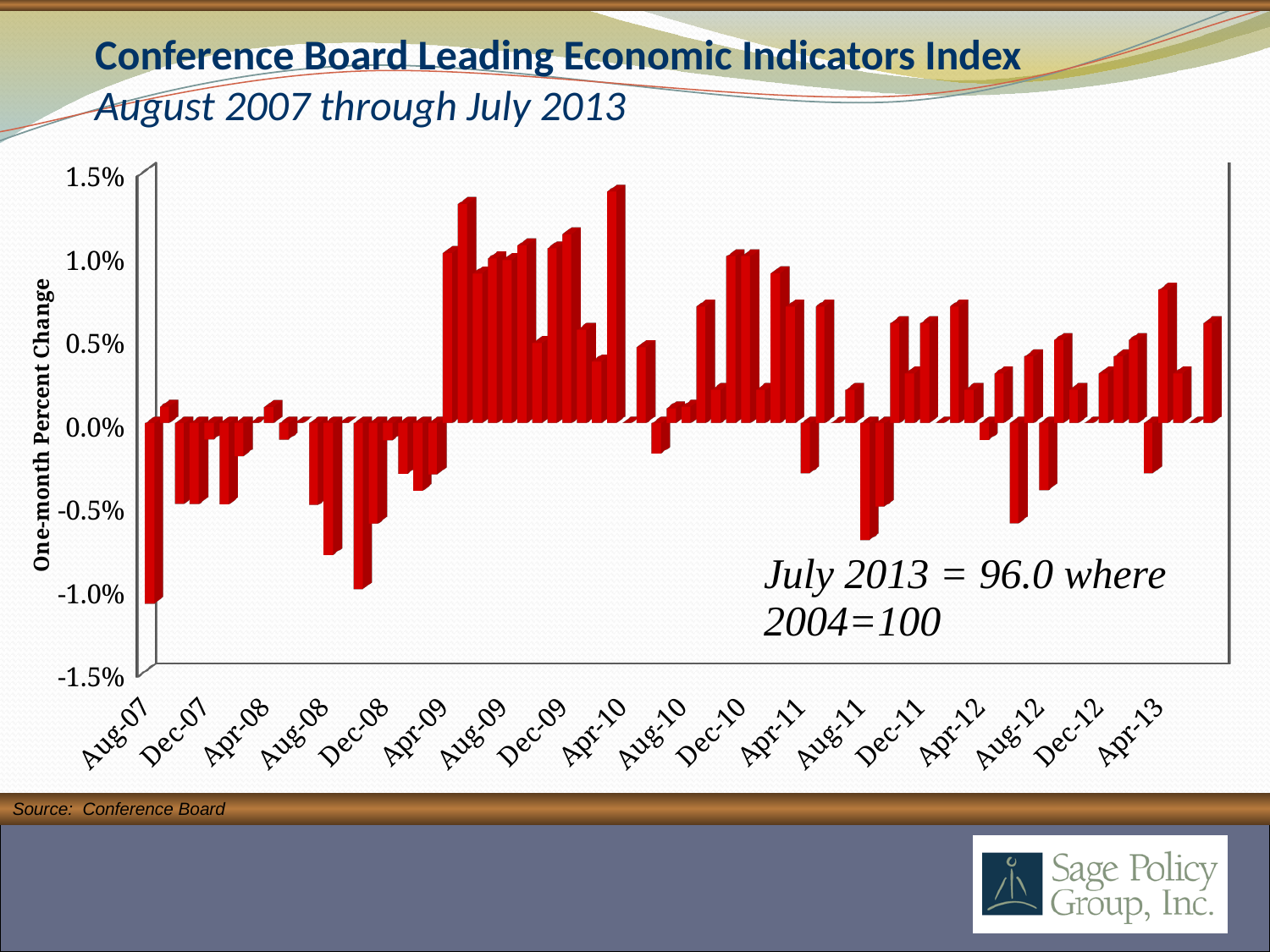
According to the annotation on the chart, what was the index value in July 2013? 96.0 What period does the chart cover, according to the subtitle? August 2007 through July 2013 What is the highest value shown on the vertical axis? 1.5% What is the source cited for the chart data? Conference Board According to the annotation on the chart, which year is the base year where the index equals 100? 2004 Is the value for Aug-07 greater or less than 0.0%? less What kind of chart is shown on the slide? Bar chart Is the value for Aug-07 greater or less than -0.5%? less How many monthly bars are plotted in the chart, given it covers August 2007 through July 2013? 72 What is the lowest value shown on the vertical axis? -1.5% What is the title of the chart on the slide? Conference Board Leading Economic Indicators Index